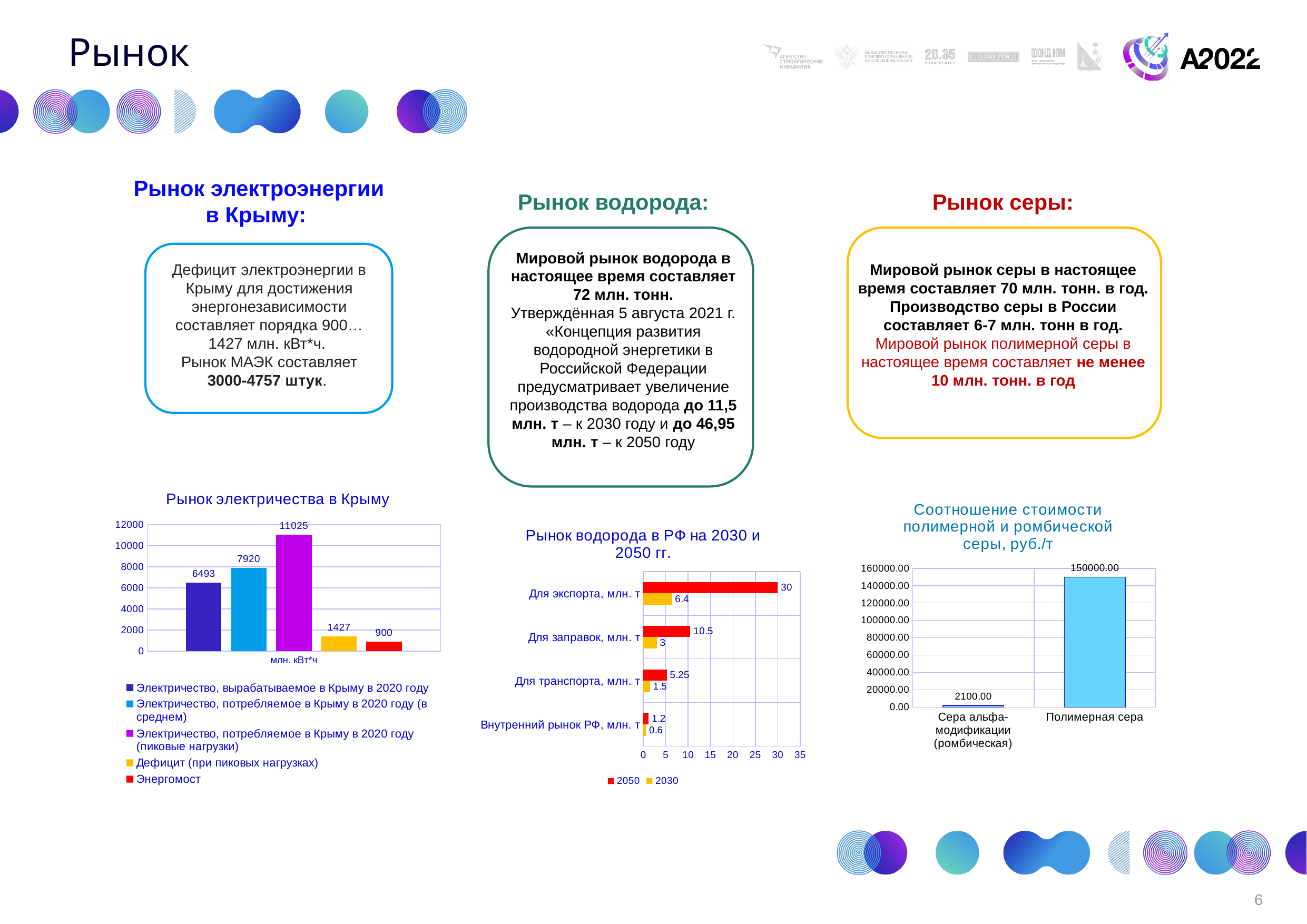
How many series does the legend of the chart 'Рынок электричества в Крыму' list? 5 In the chart 'Рынок водорода в РФ на 2030 и 2050 гг.', what is the 2050 value for 'Для экспорта, млн. т'? 30 In the chart 'Рынок водорода в РФ на 2030 и 2050 гг.', what is the difference between the 2050 and 2030 values for 'Для транспорта, млн. т'? 3.75 In the chart 'Рынок электричества в Крыму', what is the difference between 'Электричество, потребляемое в Крыму в 2020 году (в среднем)' and 'Электричество, вырабатываемое в Крыму в 2020 году'? 1427 How many categories are shown in the chart 'Рынок водорода в РФ на 2030 и 2050 гг.'? 4 In the chart 'Рынок электричества в Крыму', what is the value for 'Электричество, потребляемое в Крыму в 2020 году (пиковые нагрузки)'? 11025 What kind of chart is 'Рынок водорода в РФ на 2030 и 2050 гг.'? Bar chart In the chart 'Соотношение стоимости полимерной и ромбической серы, руб./т', which category has the higher value: 'Сера альфа-модификации (ромбическая)' or 'Полимерная сера'? Полимерная сера In the chart 'Рынок водорода в РФ на 2030 и 2050 гг.', what is the 2030 value for 'Для заправок, млн. т'? 3 In the chart 'Рынок электричества в Крыму', which series has the lowest value? Энергомост In the chart 'Соотношение стоимости полимерной и ромбической серы, руб./т', what is the difference between 'Полимерная сера' and 'Сера альфа-модификации (ромбическая)'? 147900.00 In the chart 'Соотношение стоимости полимерной и ромбической серы, руб./т', what is the value for 'Полимерная сера'? 150000.00